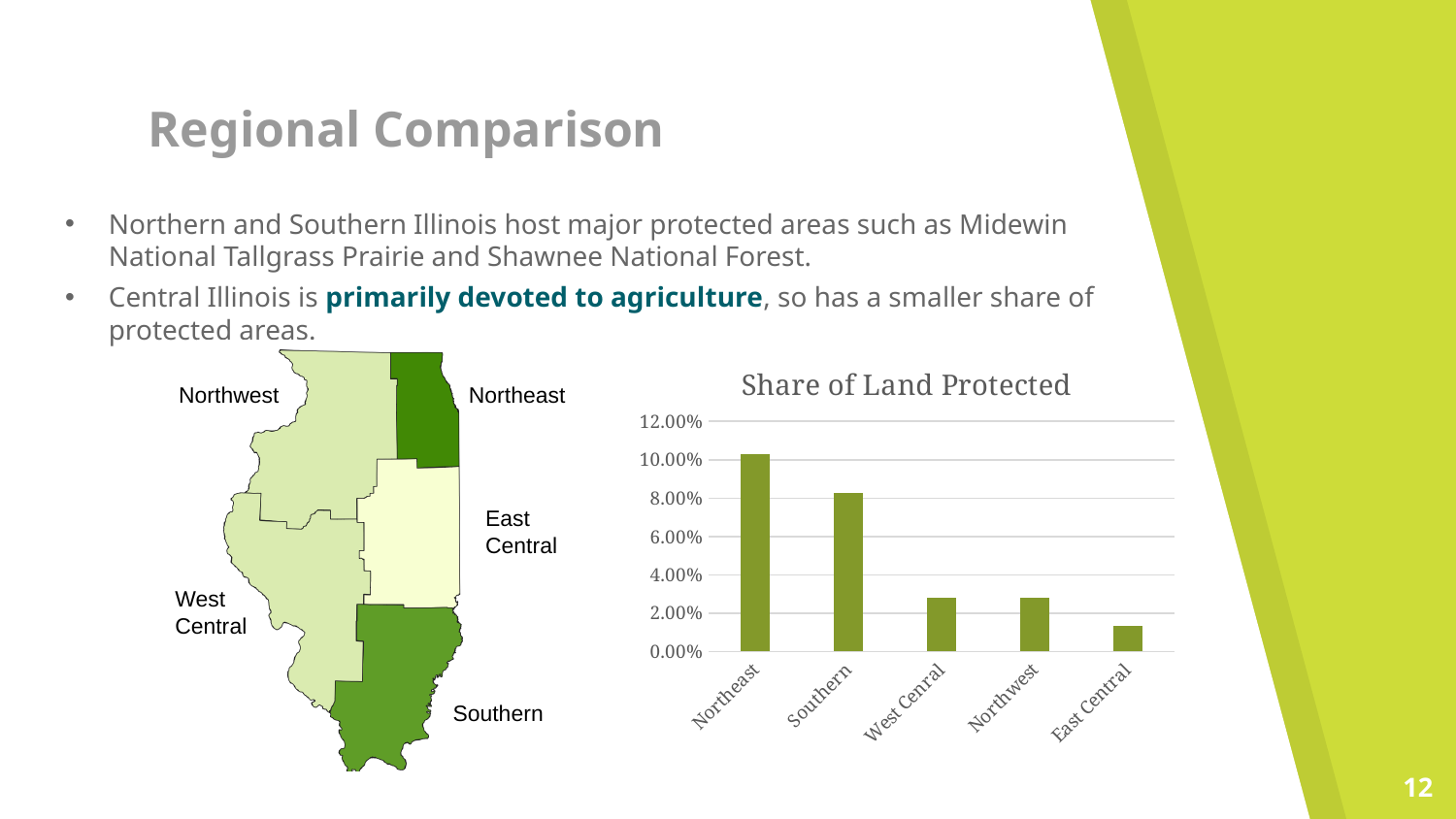
What is the title of the chart? Share of Land Protected Is the value for Northwest greater or less than 4.00%? less Do the bar values generally rise or fall from left to right along the x axis? fall What kind of chart is shown on the slide? bar chart Which region has the highest share of land protected? Northeast How many regions are plotted in the chart? 5 Which has a larger share of land protected, Northeast or Southern? Northeast Is the value for Northeast greater or less than 10.00%? greater Is the value for East Central greater or less than 2.00%? less Which region has the lowest share of land protected? East Central Which has a larger share of land protected, Southern or West Central? Southern